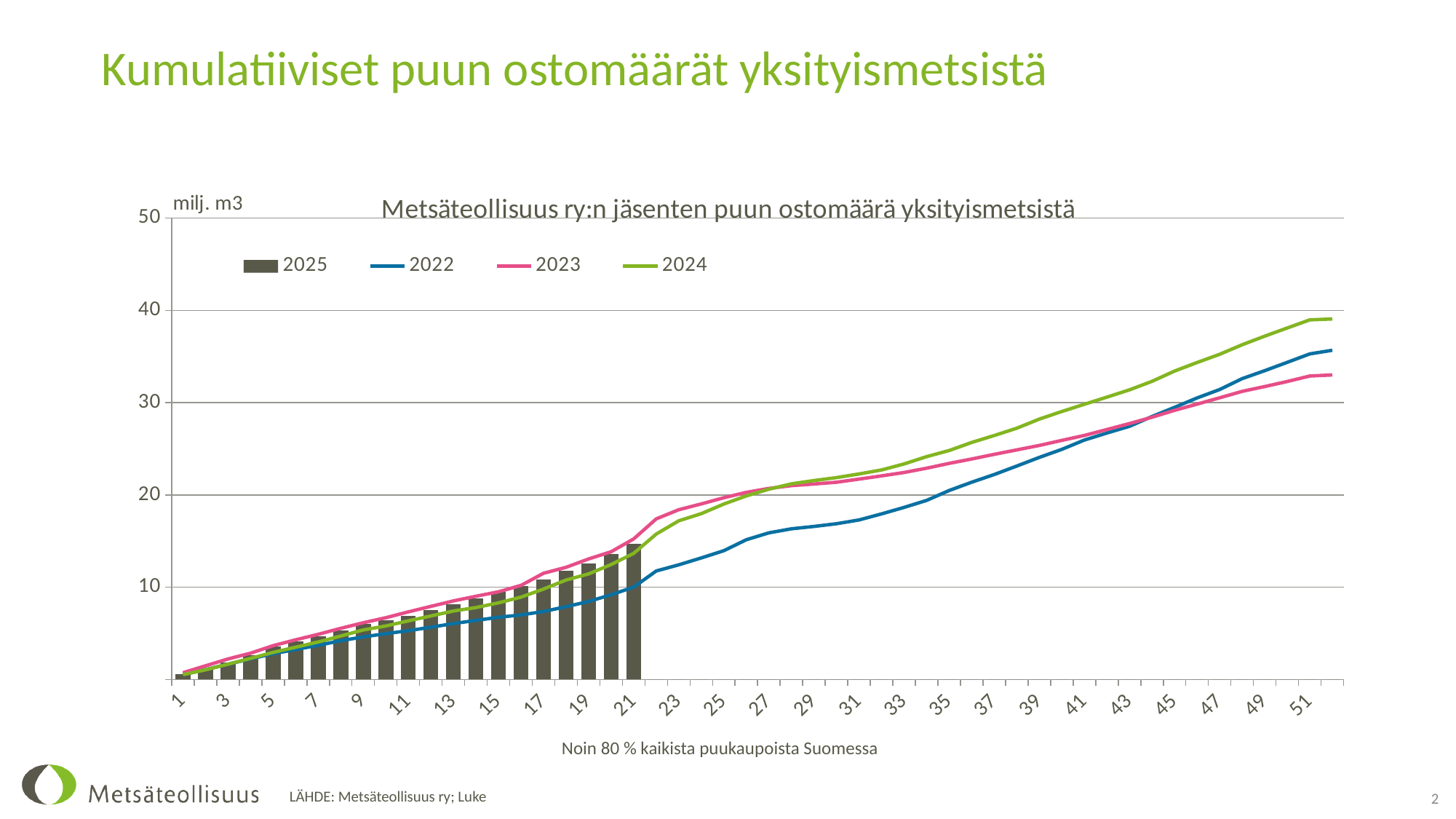
Is the value of the 2024 line at week 51 greater or less than 30? greater Which series has the highest value at week 51? 2024 How many series does the chart legend list? 4 Do the values of the 2024 line rise or fall along the x axis? Rise Which series has the lowest value at week 51? 2023 At week 21, which is larger: the 2025 bar or the 2022 line? 2025 What kind of chart is shown on the slide? A combined bar and line chart At week 31, which is larger: the 2023 line or the 2022 line? 2023 What is the title of the chart? Metsäteollisuus ry:n jäsenten puun ostomäärä yksityismetsistä Is the value of the 2025 bar at week 21 greater or less than 10? greater Which series is drawn as bars rather than a line? 2025 Is the value of the 2022 line at week 31 greater or less than 20? less